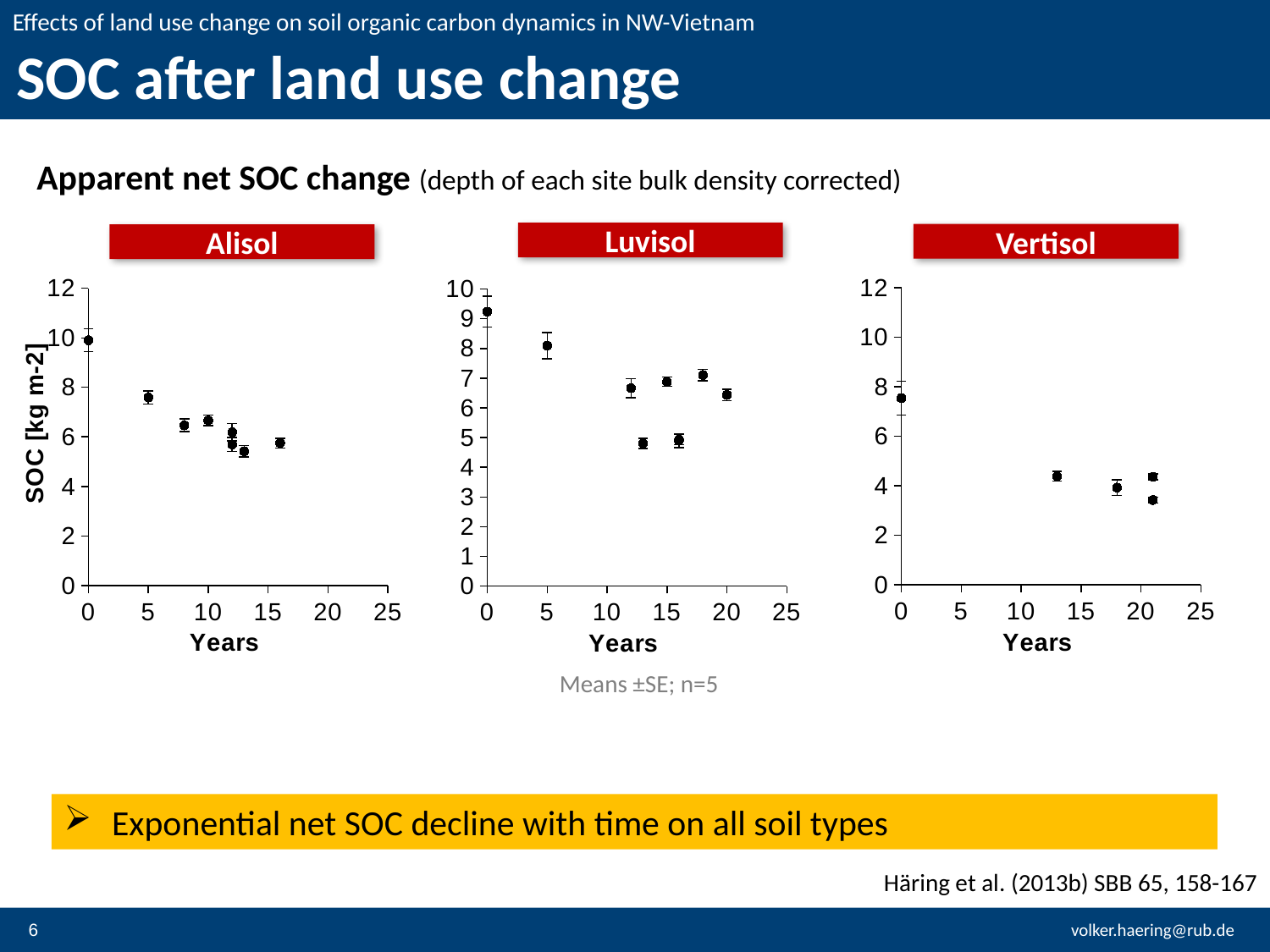
In the Vertisol chart, is the SOC value at year 0 larger or smaller than the value at year 13? larger In the Luvisol chart, is the SOC value at year 0 greater or less than 8? greater What kind of chart is the Alisol chart? scatter chart How many data points are plotted in the Vertisol chart? 5 In the Alisol chart, at which year is the SOC value highest? 0 In the Vertisol chart, do SOC values rise or fall as years increase? fall In the Alisol chart, do SOC values rise or fall as years increase? fall In the Vertisol chart, is the SOC value at year 18 greater or less than 6? less What is the y-axis label of the Alisol chart? SOC [kg m-2] In the Luvisol chart, is the SOC value at year 13 greater or less than 6? less